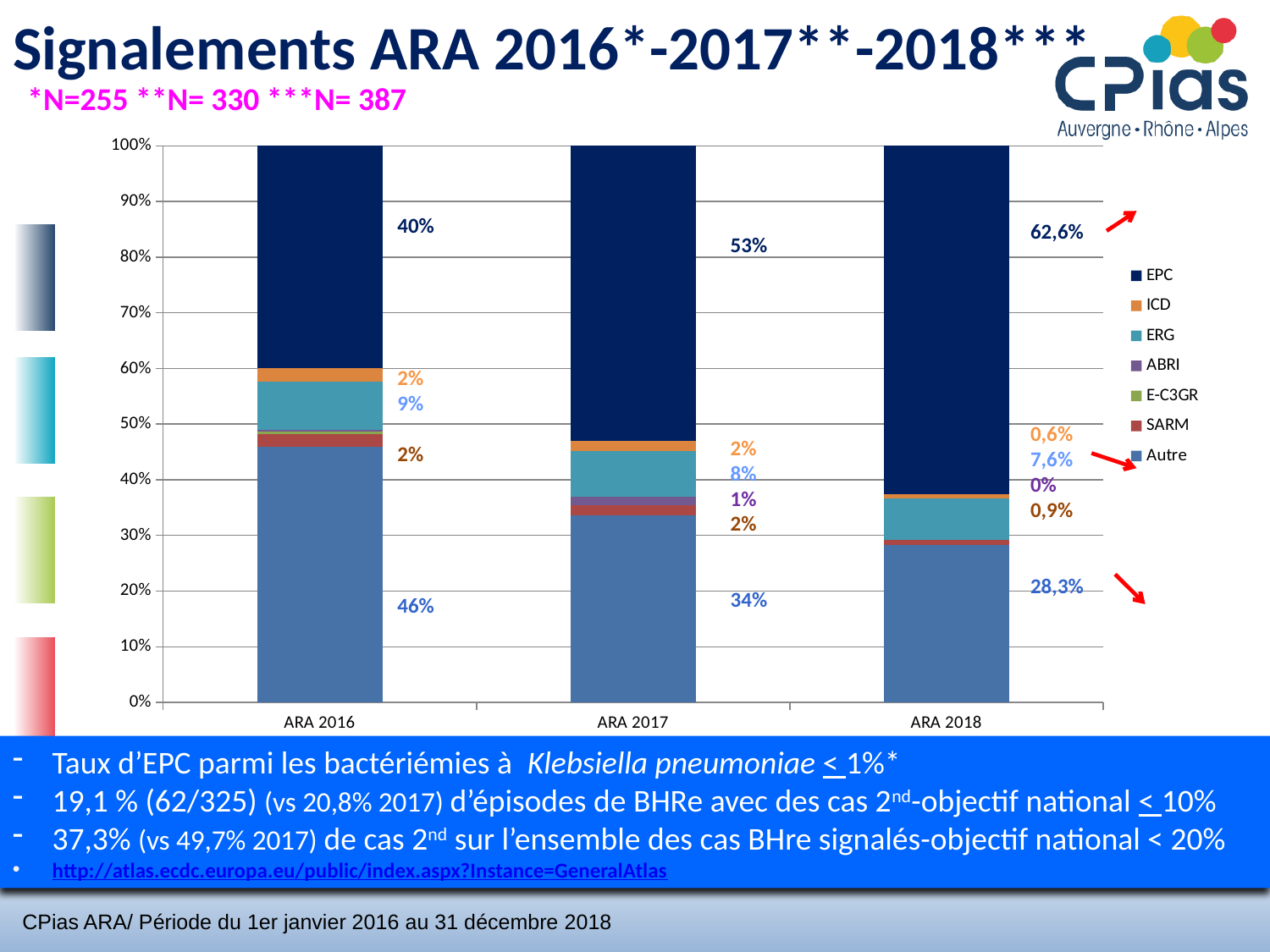
What is the value for ABRI in ARA 2017? 1% How many series does the legend list? 7 Does the EPC share rise or fall from ARA 2016 to ARA 2018? rise What is the value for Autre in ARA 2016? 46% What is the value for ERG in ARA 2017? 8% What is the value for EPC in ARA 2018? 62,6% Which is larger, the Autre share in ARA 2016 or in ARA 2017? ARA 2016 In which year is the EPC share highest? ARA 2018 In which year is the Autre share lowest? ARA 2018 What kind of chart is shown on the slide? stacked bar chart What is the value for SARM in ARA 2018? 0,9% What is the difference between the EPC share in ARA 2018 and in ARA 2017? 9,6%